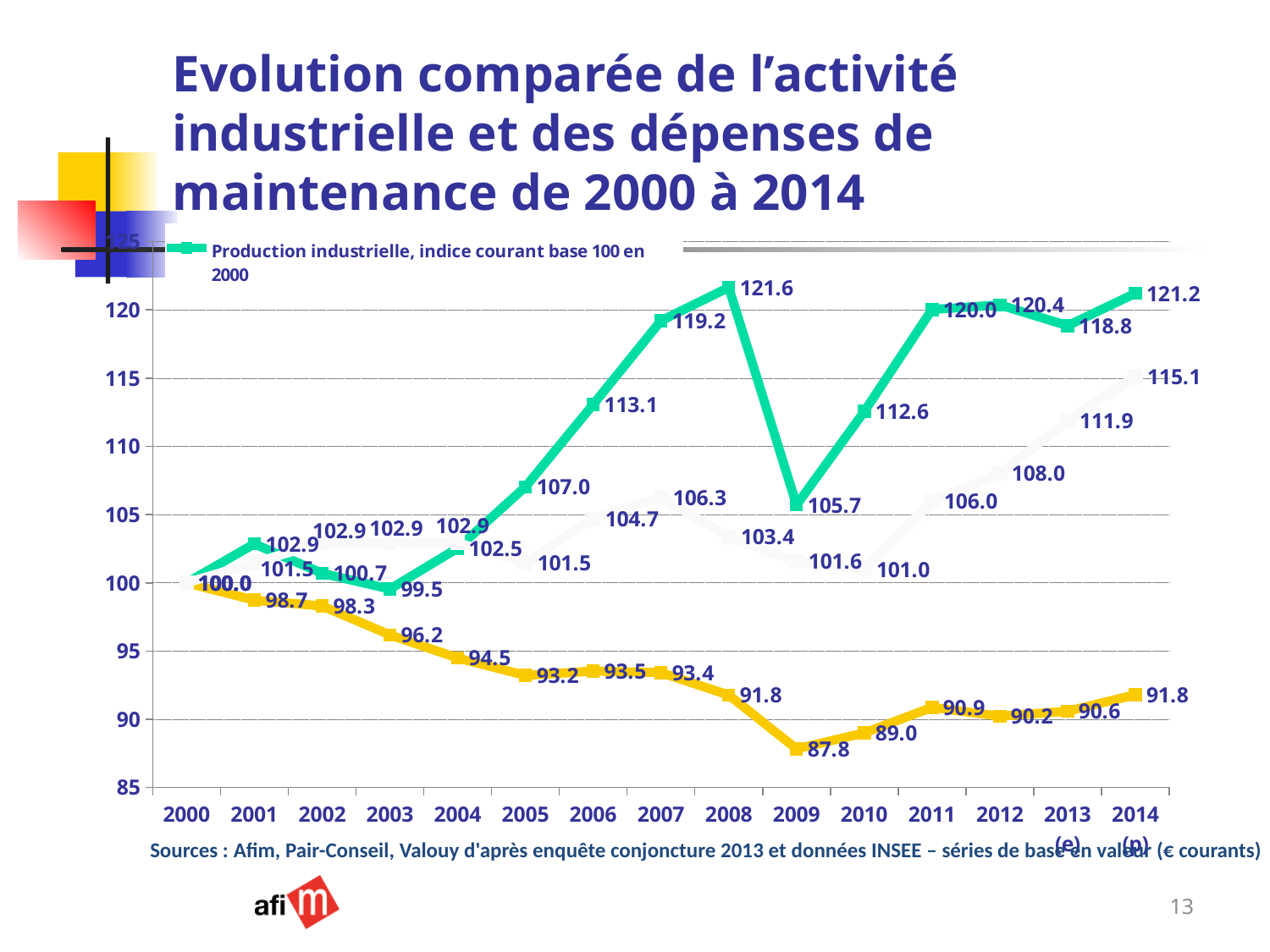
In which year does the 'Production industrielle, indice courant base 100 en 2000' series reach its highest value? 2008 What is the value of the 'Production industrielle, indice courant base 100 en 2000' series in 2000? 100.0 How many years are shown on the x axis of the chart? 15 What is the value of the yellow line in 2009? 87.8 What is the value of the 'Production industrielle, indice courant base 100 en 2000' series in 2014? 121.2 In which year does the yellow line reach its lowest value? 2009 Does the 'Production industrielle, indice courant base 100 en 2000' series rise or fall between 2004 and 2008? Rise What kind of chart is shown on the slide? Line chart By how much does the 'Production industrielle, indice courant base 100 en 2000' series fall from 2008 to 2009? 15.9 For the 'Production industrielle, indice courant base 100 en 2000' series, which year has the larger value, 2011 or 2012? 2012 What is the value of the 'Production industrielle, indice courant base 100 en 2000' series in 2008? 121.6 In which year does the 'Production industrielle, indice courant base 100 en 2000' series reach its lowest value? 2003